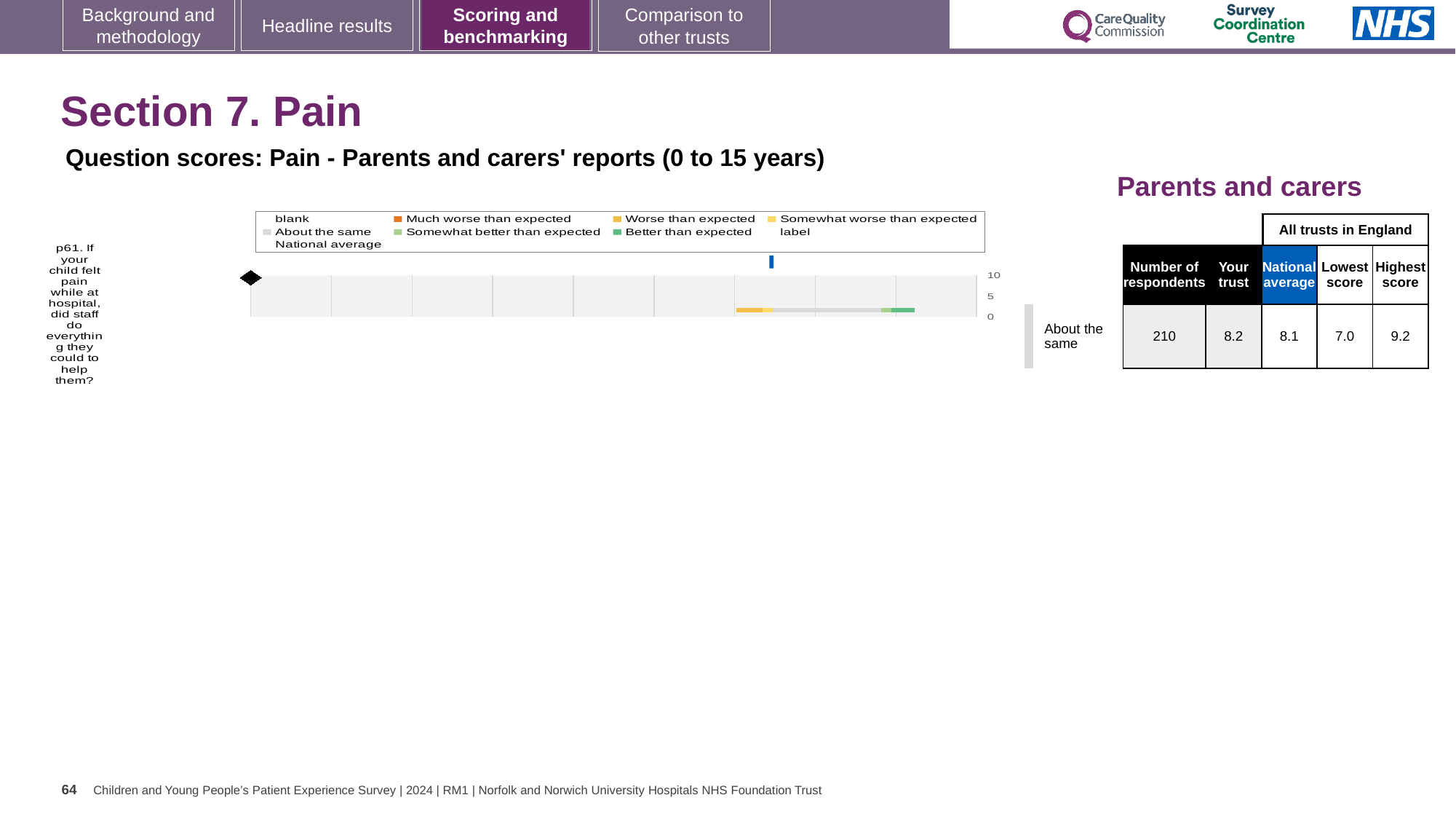
Which is larger for question p61, the 'Your trust' score or the national average? Your trust What benchmarking category is question p61 assigned to? About the same What is the lowest score among all trusts in England for question p61? 7.0 What kind of chart is shown on the slide? bar chart What is the highest score among all trusts in England for question p61? 9.2 Which colour in the legend represents 'Better than expected'? green What is the difference between the highest and lowest scores among all trusts in England for question p61? 2.2 How many survey questions are plotted in the chart? 1 What is the 'Your trust' score for question p61 in the Parents and carers table? 8.2 What is the highest value shown on the chart's axis? 10 How many respondents answered question p61? 210 What is the national average score for question p61? 8.1